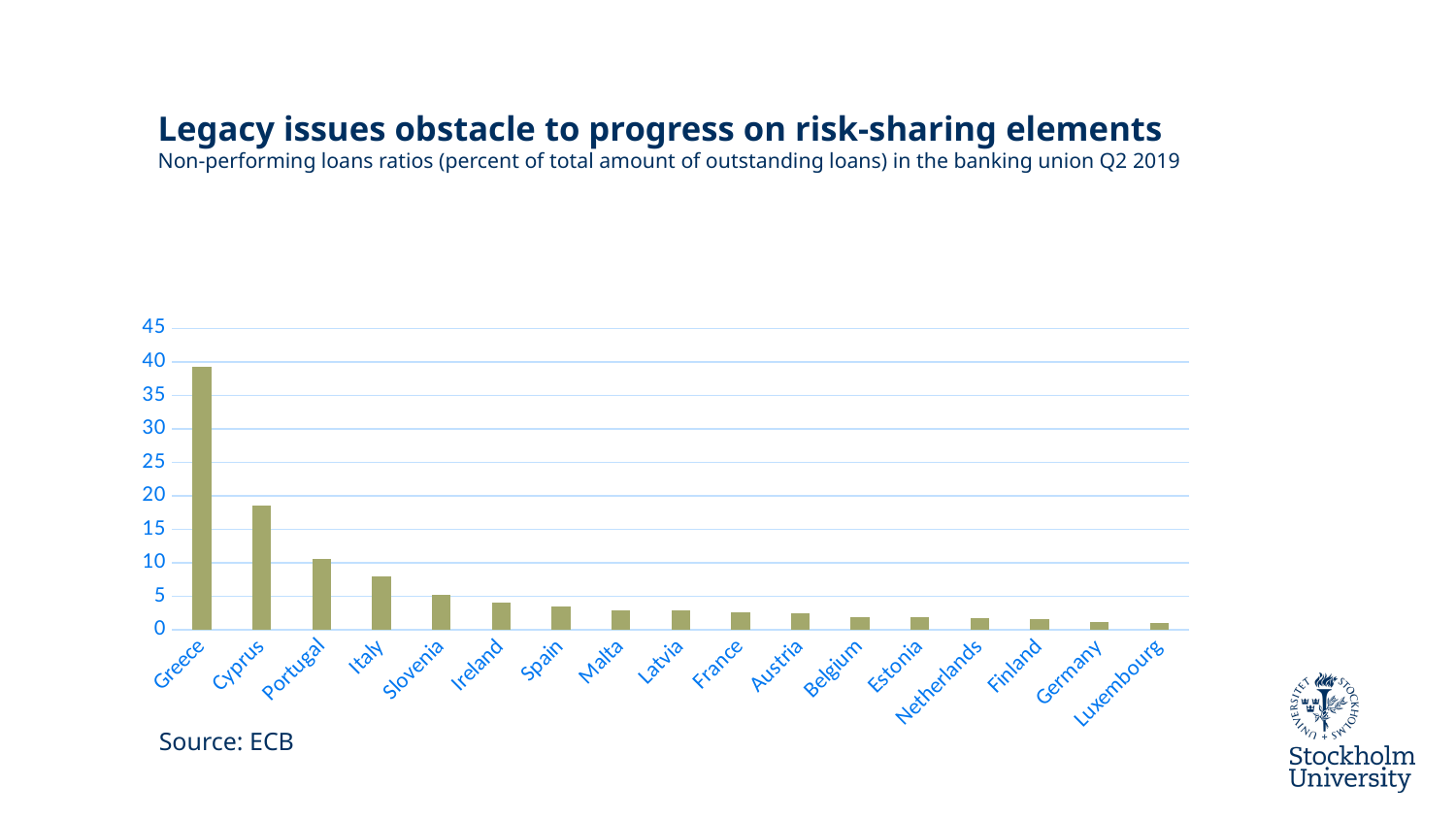
Is the value for Cyprus greater or less than 20? less Which country has the lowest non-performing loans ratio in the chart? Luxembourg Which has a higher non-performing loans ratio, Cyprus or Portugal? Cyprus Is the value for Greece greater or less than 35? greater Is the value for Italy greater or less than 10? less What kind of chart is shown on the slide? Bar chart What is the source cited for the chart data? ECB How many countries are shown on the x axis of the chart? 17 Which country has the highest non-performing loans ratio in the chart? Greece Which has a higher non-performing loans ratio, Italy or Slovenia? Italy Do the values rise or fall moving from left to right along the x axis? Fall